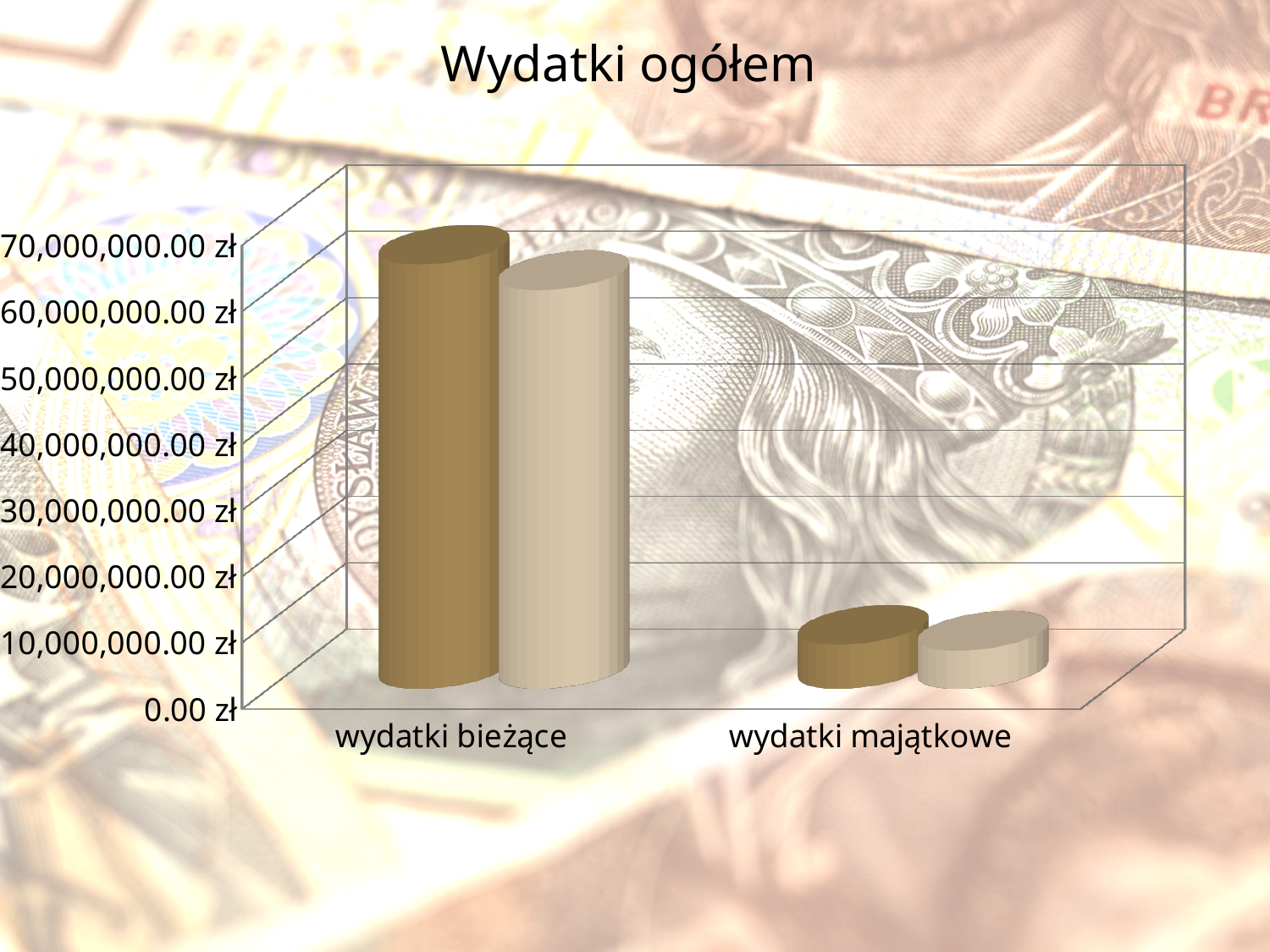
What kind of chart is shown on the slide? bar chart Are the values for wydatki majątkowe greater or less than 30,000,000.00 zł? less How many bars are shown for each category in the chart? 2 Which category has the highest values in the chart? wydatki bieżące How many categories are shown on the x axis of the chart? 2 What is the highest value labelled on the vertical axis of the chart? 70,000,000.00 zł What is the title of the chart? Wydatki ogółem Which category has larger values, wydatki bieżące or wydatki majątkowe? wydatki bieżące Are the values for wydatki bieżące greater or less than 40,000,000.00 zł? greater Which category has the lowest values in the chart? wydatki majątkowe Do the values rise or fall from wydatki bieżące to wydatki majątkowe along the x axis? fall